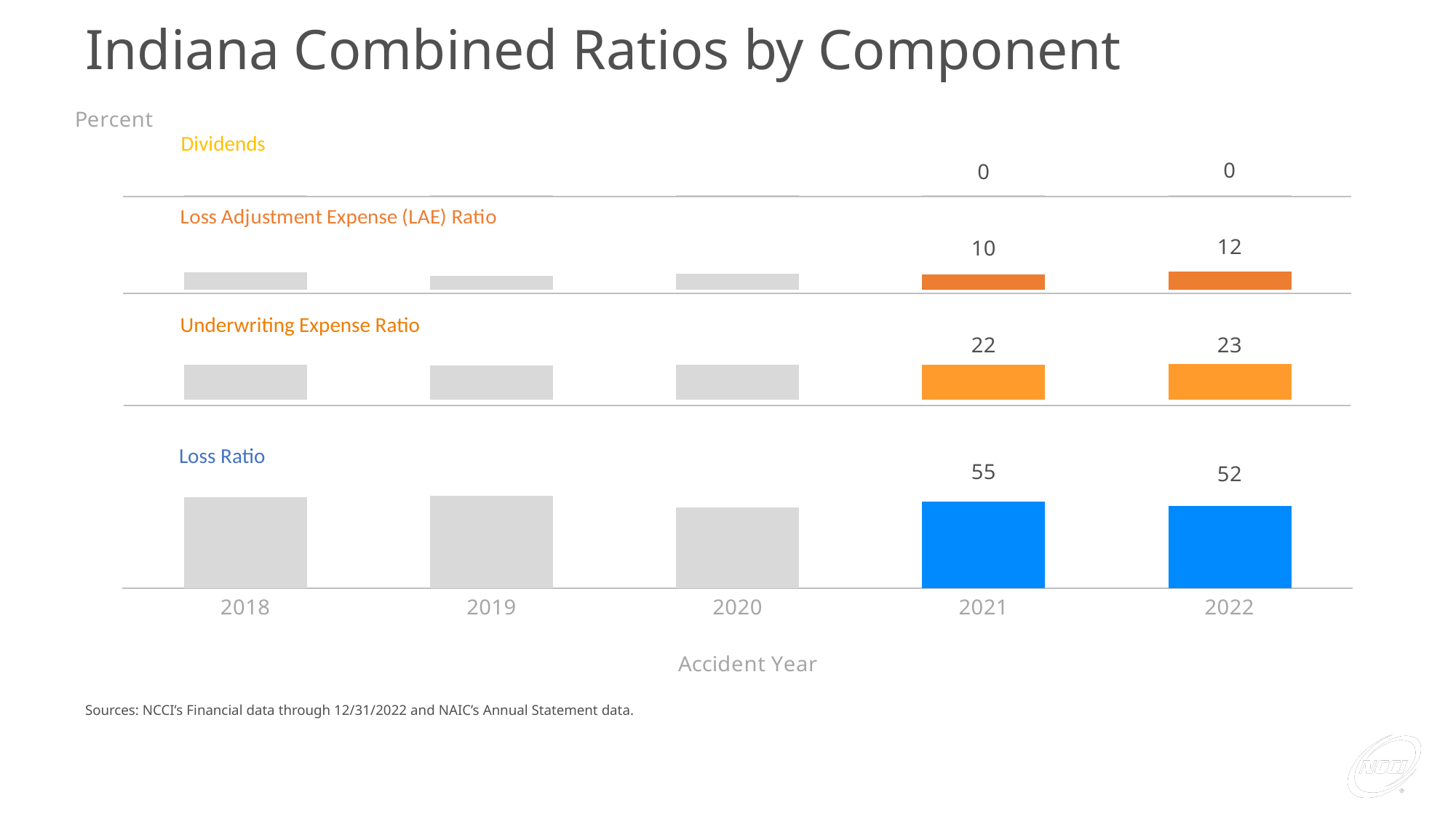
What is the Dividends value for accident year 2022? 0 How many accident years are shown on the x axis? 5 How many components of the combined ratio are shown on the chart? 4 What is the sum of the four labeled components for accident year 2021? 87 What is the Loss Ratio for accident year 2022? 52 What is the difference between the Underwriting Expense Ratio in 2022 and in 2021? 1 Which accident year has the higher Loss Adjustment Expense (LAE) Ratio, 2021 or 2022? 2022 What is the Underwriting Expense Ratio for accident year 2022? 23 What is the Loss Adjustment Expense (LAE) Ratio for accident year 2021? 10 By how much does the Loss Ratio in 2021 exceed the Loss Ratio in 2022? 3 What kind of chart is shown on the slide? Bar chart What is the Loss Ratio for accident year 2021? 55